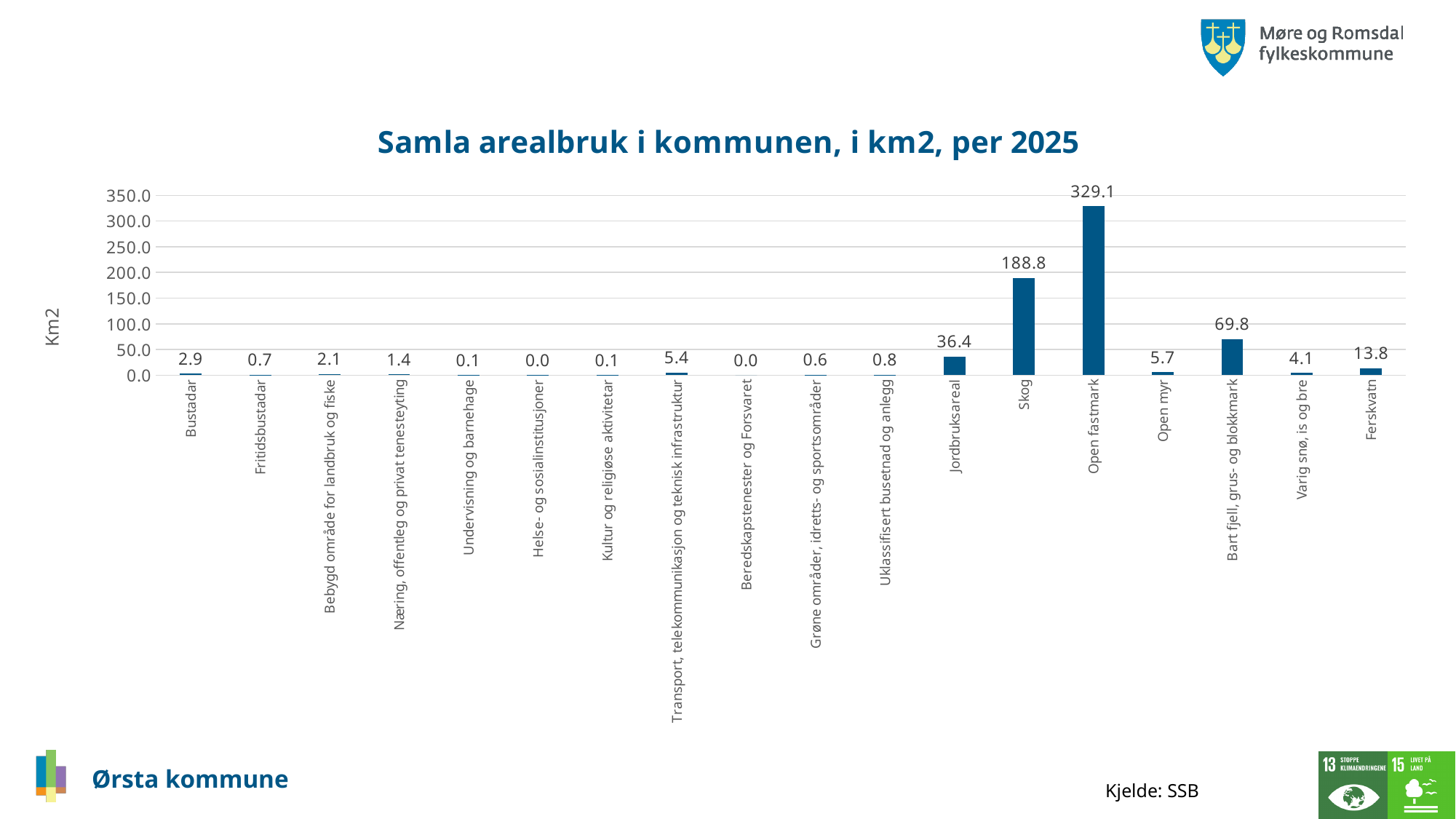
What is the title of the chart? Samla arealbruk i kommunen, i km2, per 2025 Is the value for Skog greater or less than 150.0? greater What is the difference between the values for Bart fjell, grus- og blokkmark and Jordbruksareal? 33.4 What is the value for Jordbruksareal? 36.4 What kind of chart is shown on the slide? bar chart Which category has the highest value? Open fastmark Which is larger, the value for Open myr or the value for Varig snø, is og bre? Open myr What is the difference between the values for Open fastmark and Skog? 140.3 What is the value for Open fastmark? 329.1 What is the value for Skog? 188.8 How many categories are shown on the x axis? 18 What is the value for Ferskvatn? 13.8